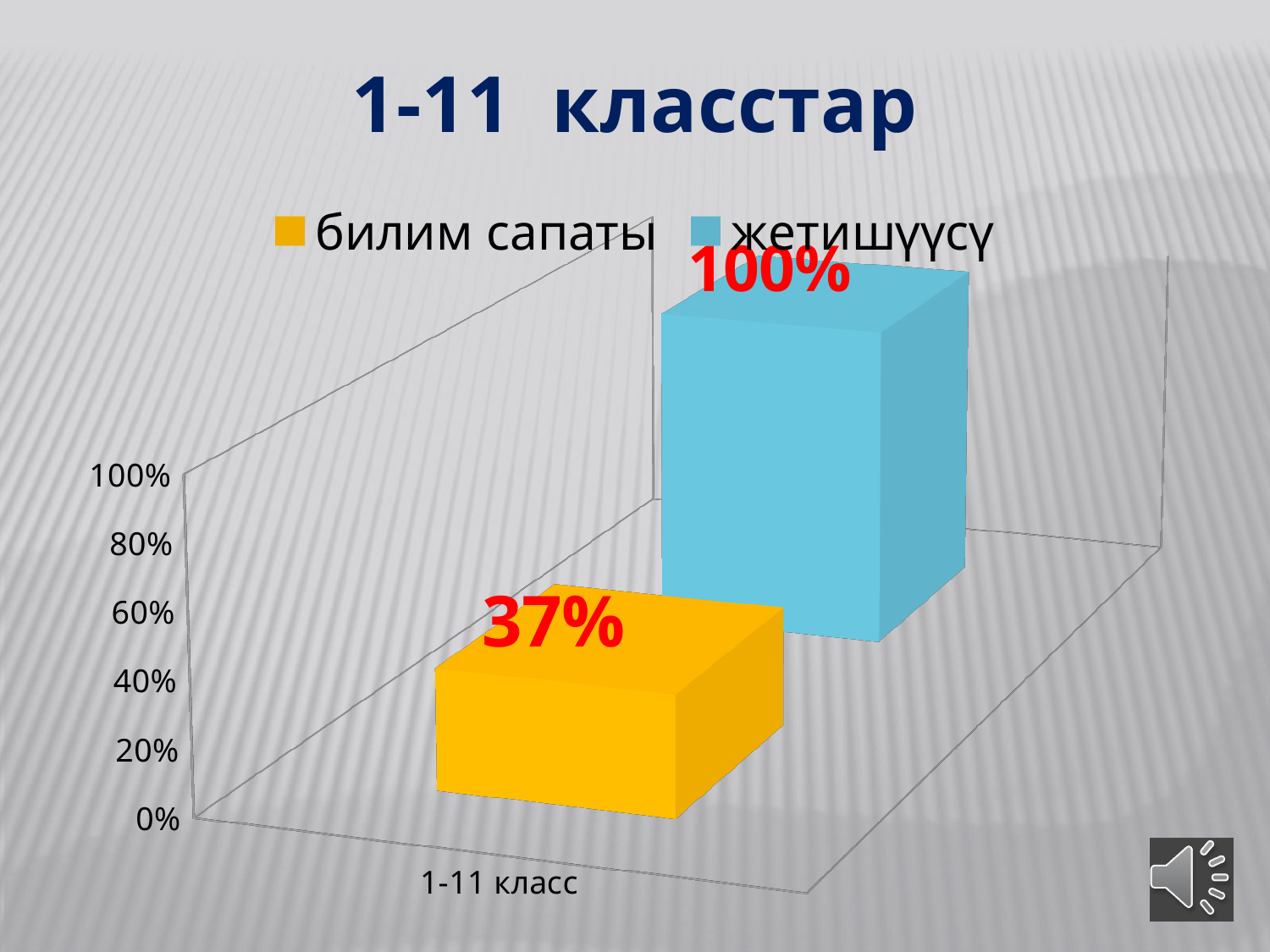
What is the value for жетишүүсү for 1-11 класс? 100% Which series has the higher value, билим сапаты or жетишүүсү? жетишүүсү Which series has the lowest value on the chart? билим сапаты What is the value for билим сапаты for 1-11 класс? 37% What kind of chart is shown on the slide? bar chart What colour is the bar for жетишүүсү? blue Is the value for билим сапаты greater or less than 40%? less What is the difference between the жетишүүсү value and the билим сапаты value? 63% How many series does the legend list? 2 Is the value for жетишүүсү greater or less than 80%? greater What is the title of the slide? 1-11 класстар How many categories are shown on the x axis? 1